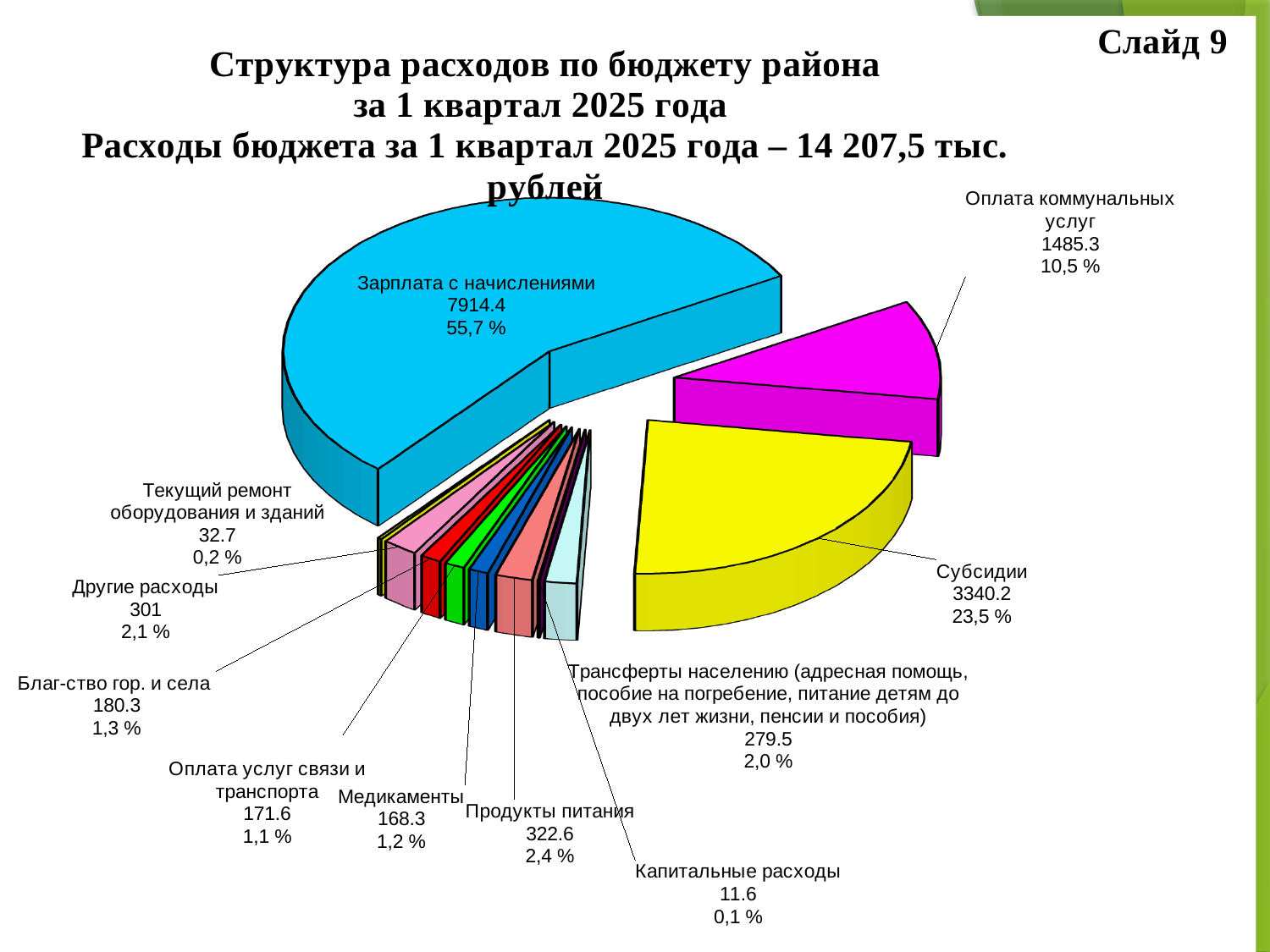
What is the value for Оплата коммунальных услуг? 1485.3 Which category has the smallest slice of the pie? Капитальные расходы What is the value for Зарплата с начислениями? 7914.4 What share of the pie does Субсидии represent? 23,5 % What share of the pie does Оплата коммунальных услуг represent? 10,5 % Which is larger, the value for Другие расходы or the value for Благ-ство гор. и села? Другие расходы How many categories are shown in the pie chart? 11 Which category has the largest slice of the pie? Зарплата с начислениями What is the value for Продукты питания? 322.6 What is the value for Субсидии? 3340.2 What kind of chart is shown on the slide? pie chart What is the difference between the values for Субсидии and Оплата коммунальных услуг? 1854.9